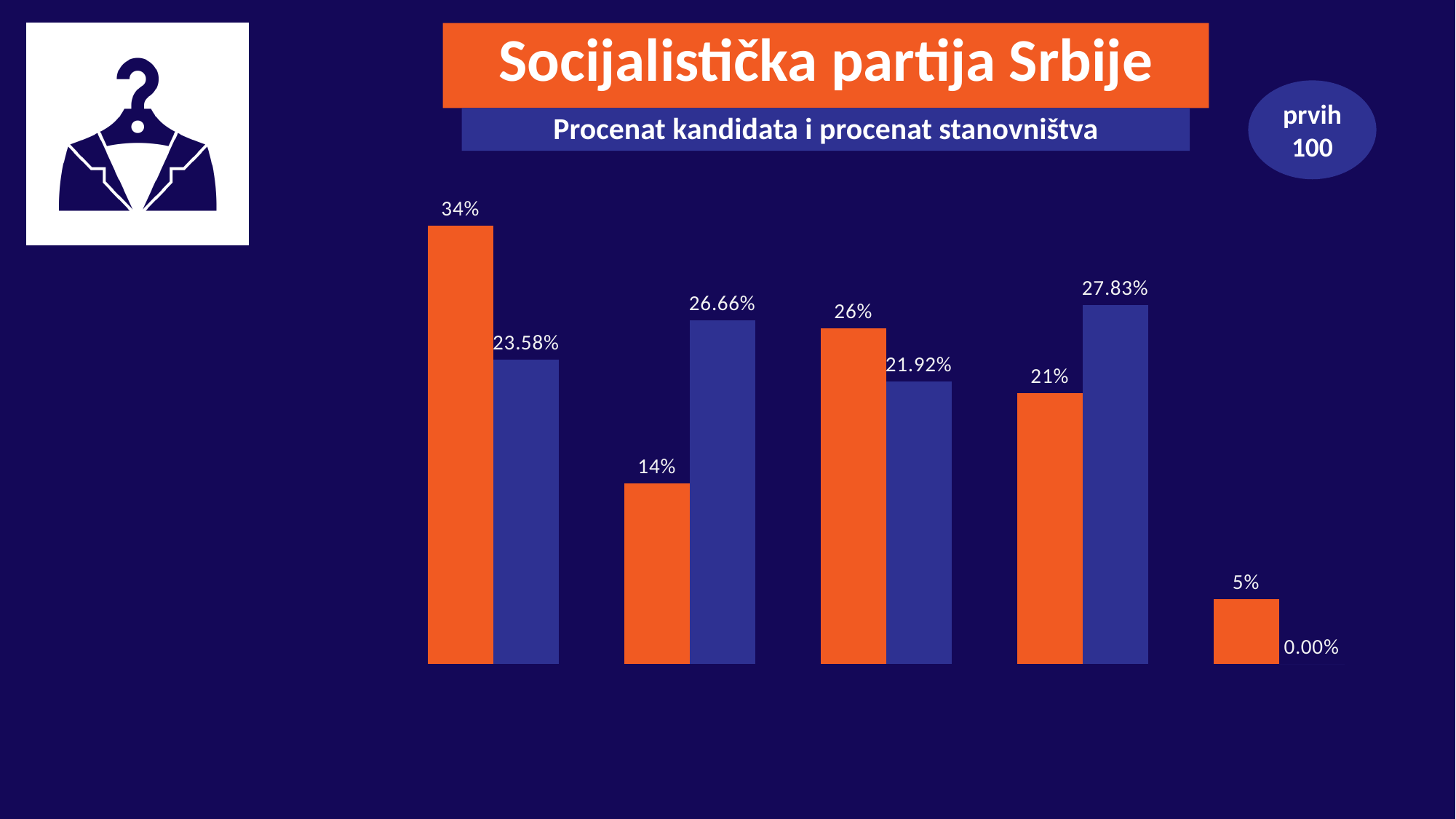
What is the main title shown above the chart? Socijalistička partija Srbije How many groups of bars are plotted in the chart? 5 What is the value of the blue bar in the fifth (rightmost) group? 0.00% Which group has the lowest blue bar? the fifth (rightmost) group, 0.00% What kind of chart is shown on the slide? bar chart What is the value of the orange bar in the first (leftmost) group? 34% In the first (leftmost) group, how much larger is the orange bar than the blue bar? 10.42 percentage points What is the value of the blue bar in the second group from the left? 26.66% What is the value of the orange bar in the fifth (rightmost) group? 5% Which group has the highest orange bar? the first (leftmost) group, 34% In the second group from the left, which bar is larger, the orange one or the blue one? the blue one (26.66%) What is the value of the blue bar in the first (leftmost) group? 23.58%